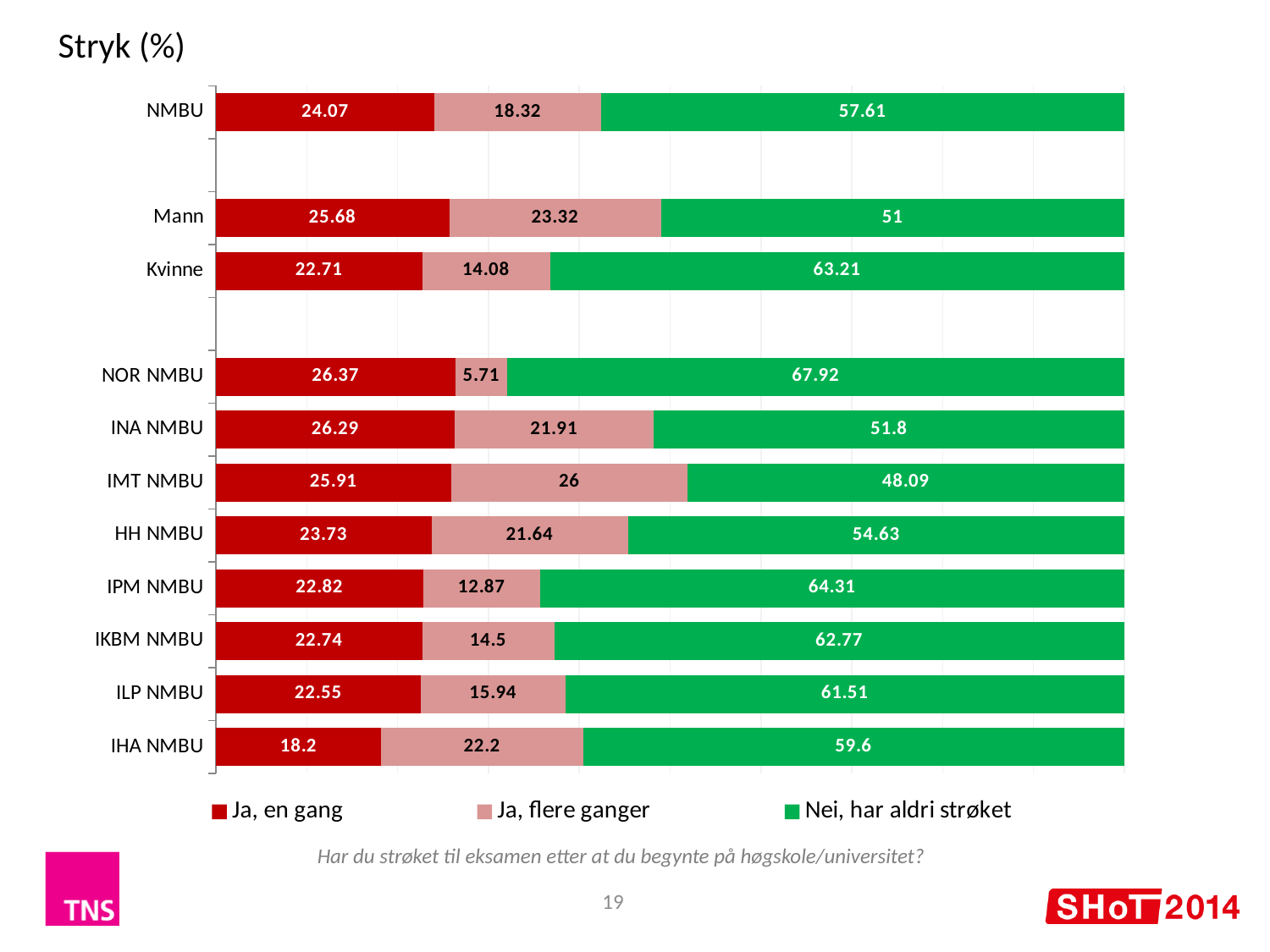
How many categories are shown on the chart? 11 Which has a larger "Ja, flere ganger" value, Mann or Kvinne? Mann How many series does the legend list? 3 What is the difference between the "Nei, har aldri strøket" values for Kvinne and Mann? 12.21 What is the value of "Ja, flere ganger" for IMT NMBU? 26 What is the value of "Ja, en gang" for Mann? 25.68 What is the title of the chart? Stryk (%) Which category has the highest value for "Nei, har aldri strøket"? NOR NMBU Which category has the lowest value for "Ja, flere ganger"? NOR NMBU What is the value of "Nei, har aldri strøket" for NOR NMBU? 67.92 Which category has the lowest value for "Ja, en gang"? IHA NMBU What kind of chart is shown on the slide? Stacked bar chart